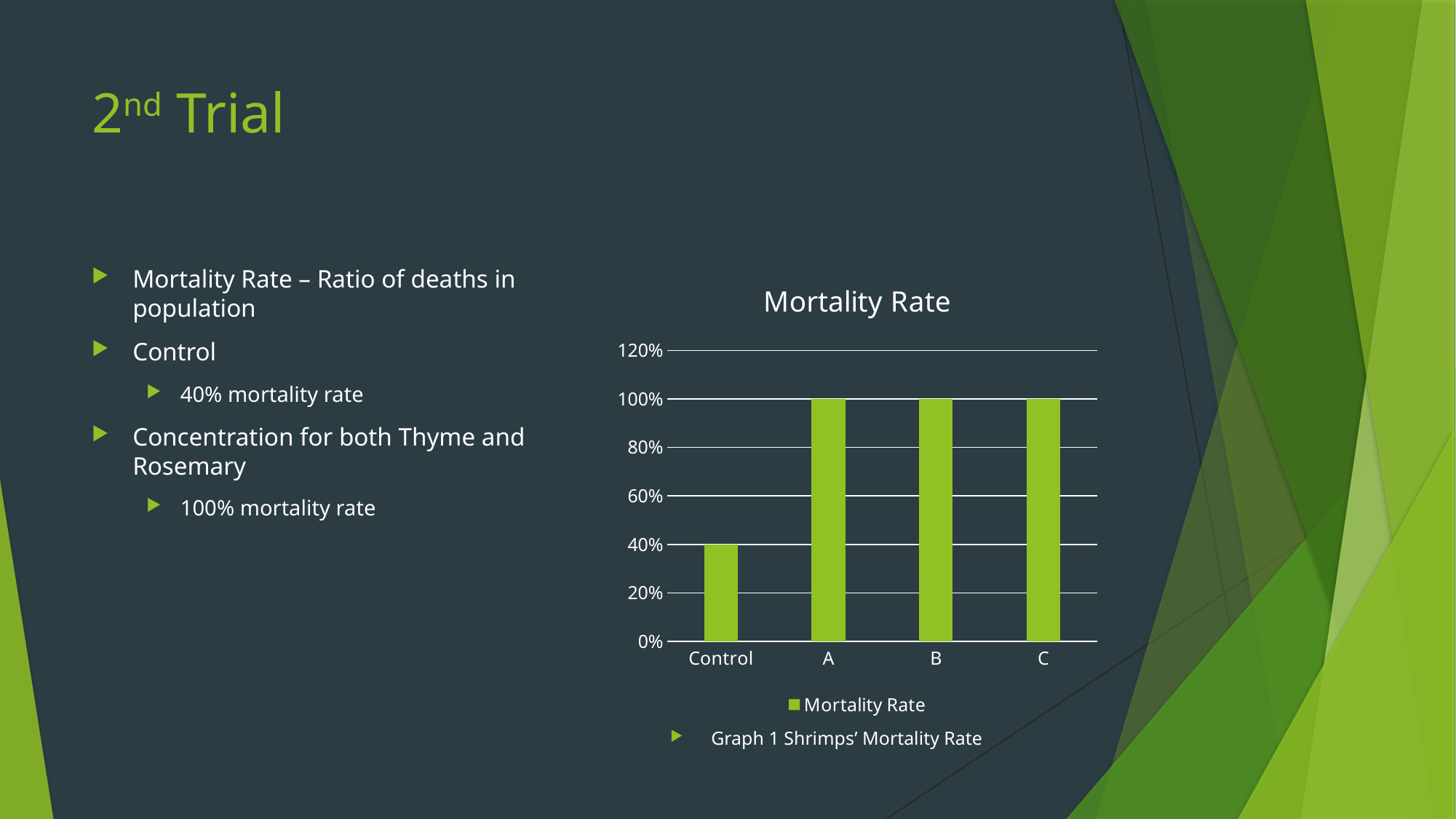
What is the mortality rate for concentration A in the Mortality Rate chart? 100% How many categories are shown on the x axis of the Mortality Rate chart? 4 What is the title of the chart on the slide? Mortality Rate Is the mortality rate for Control greater or less than 60%? less Is the mortality rate for B greater or less than 80%? greater What is the mortality rate for the Control group in the Mortality Rate chart? 40% Which category has the lowest mortality rate in the chart? Control How many series does the legend of the Mortality Rate chart list? 1 What is the mortality rate for concentration C in the Mortality Rate chart? 100% Which has a higher mortality rate, Control or A? A What kind of chart is shown on the slide? bar chart What is the difference between the mortality rate for B and the mortality rate for Control? 60%